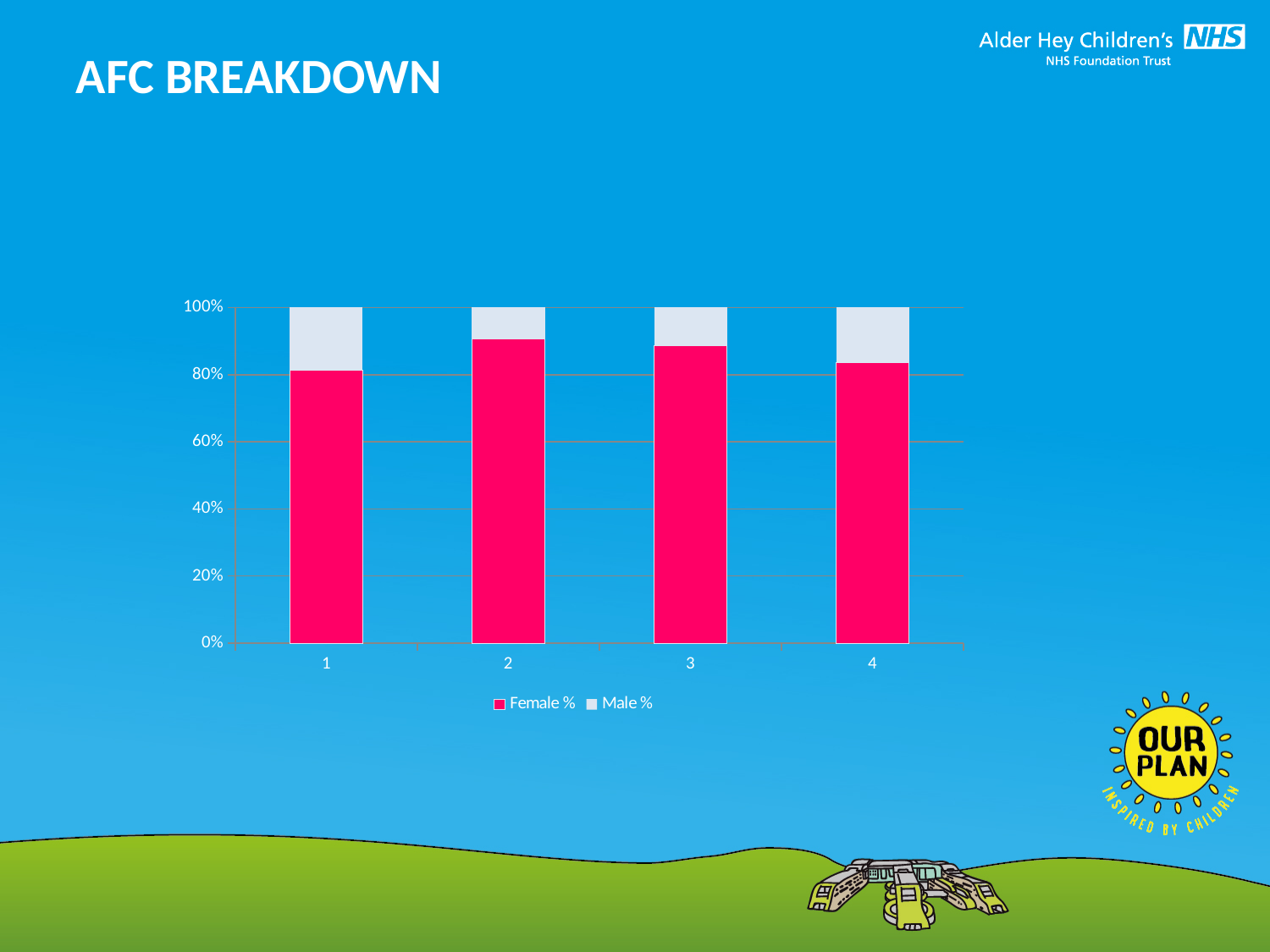
Is the Female % value for category 2 greater or less than 80%? greater Is the Female % value for category 1 greater or less than 60%? greater How many series does the chart's legend list? 2 Is the Male % value for category 2 greater or less than 20%? less Is the Female % value larger for category 1 or category 2? Category 2 Which category has the highest Female % value? 2 What kind of chart is shown on the slide? Stacked bar chart How many categories are shown on the x axis of the chart? 4 What is the total height of the stacked bar for category 1? 100% What are the two series listed in the chart's legend? Female % and Male % What is the title of the slide containing the chart? AFC BREAKDOWN